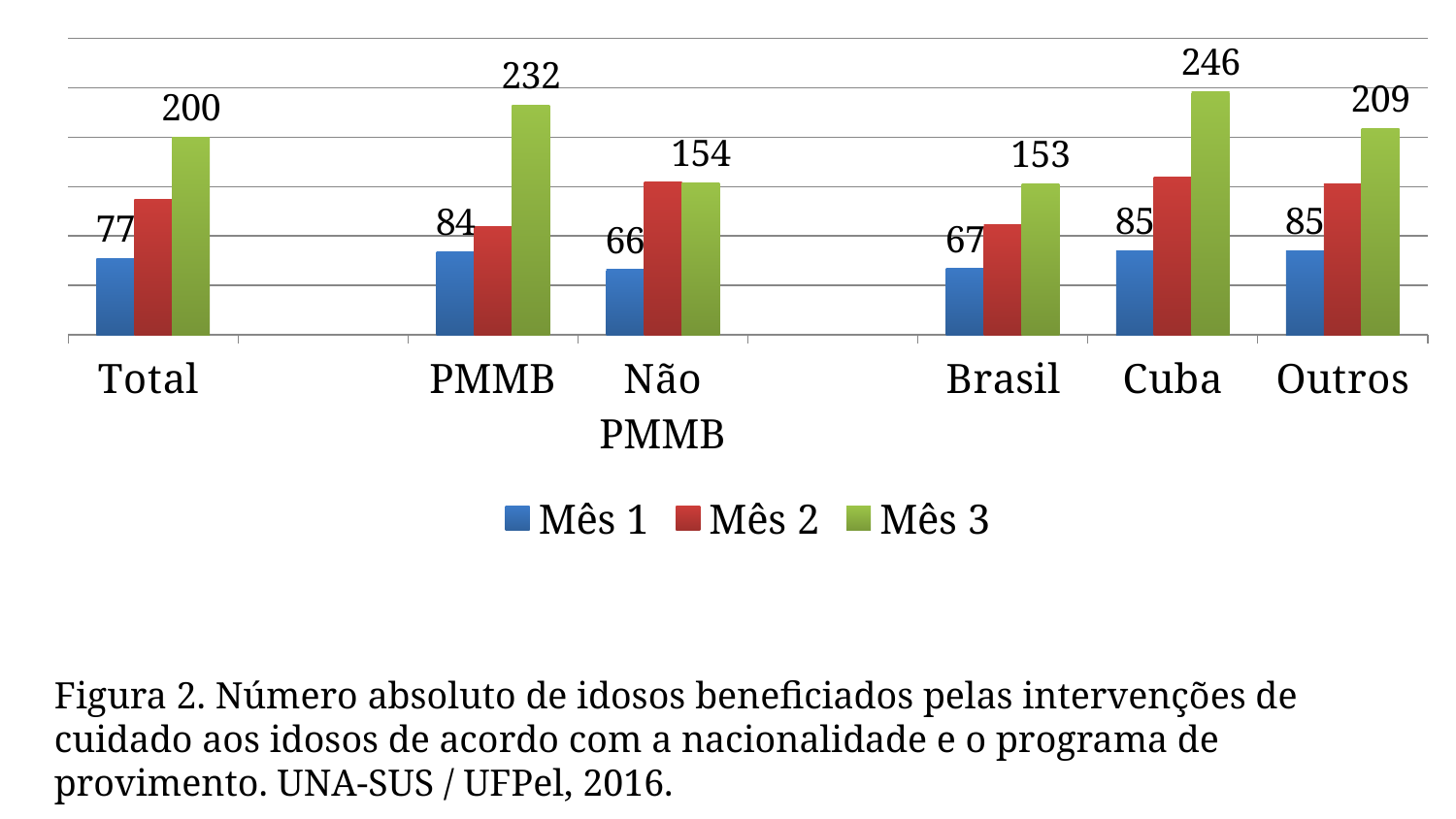
What is the difference between the Mês 3 values for Cuba and Brasil? 93 What is the difference between the Mês 3 and Mês 1 values for Total? 123 Which has the larger Mês 3 value, PMMB or Outros? PMMB Which category has the lowest Mês 1 value? Não PMMB What kind of chart is shown on the slide? bar chart How many series does the legend list? 3 Which category has the highest Mês 3 value? Cuba What is the Mês 3 value for Cuba? 246 What is the Mês 3 value for PMMB? 232 What is the Mês 1 value for Não PMMB? 66 How many categories are shown on the x axis? 6 What is the Mês 1 value for Total? 77